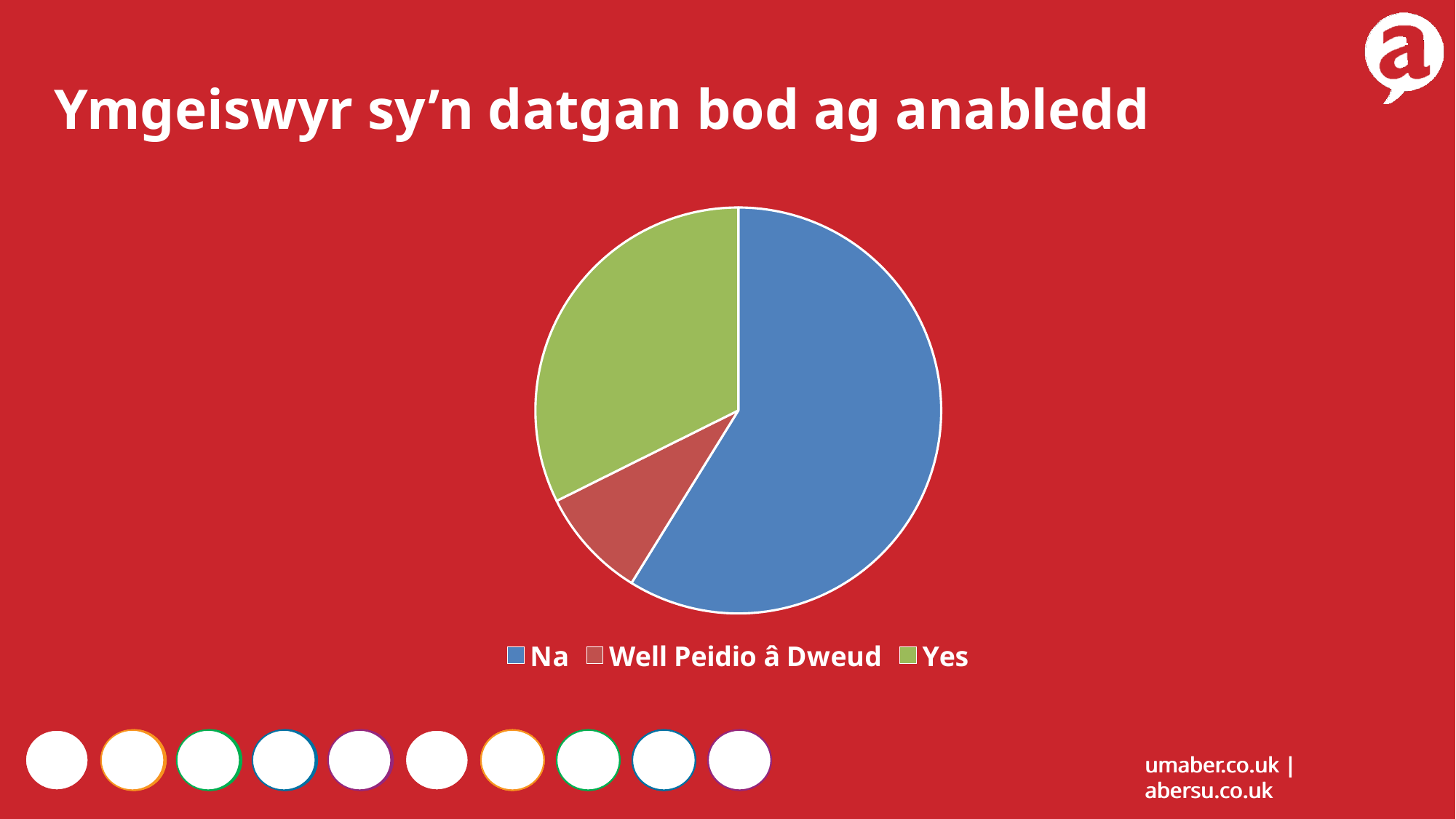
What colour is the Yes slice in the pie chart? Green Which slice is larger, Yes or Well Peidio â Dweud? Yes What kind of chart is shown on the slide? Pie chart What is the title of the slide containing the pie chart? Ymgeiswyr sy’n datgan bod ag anabledd How many entries does the legend of the pie chart list? 3 Which slice is larger, Na or Yes? Na How many slices does the pie chart have? 3 Which category has the smallest slice of the pie chart? Well Peidio â Dweud Which category has the largest slice of the pie chart? Na Is the Na slice greater or less than half of the pie? greater